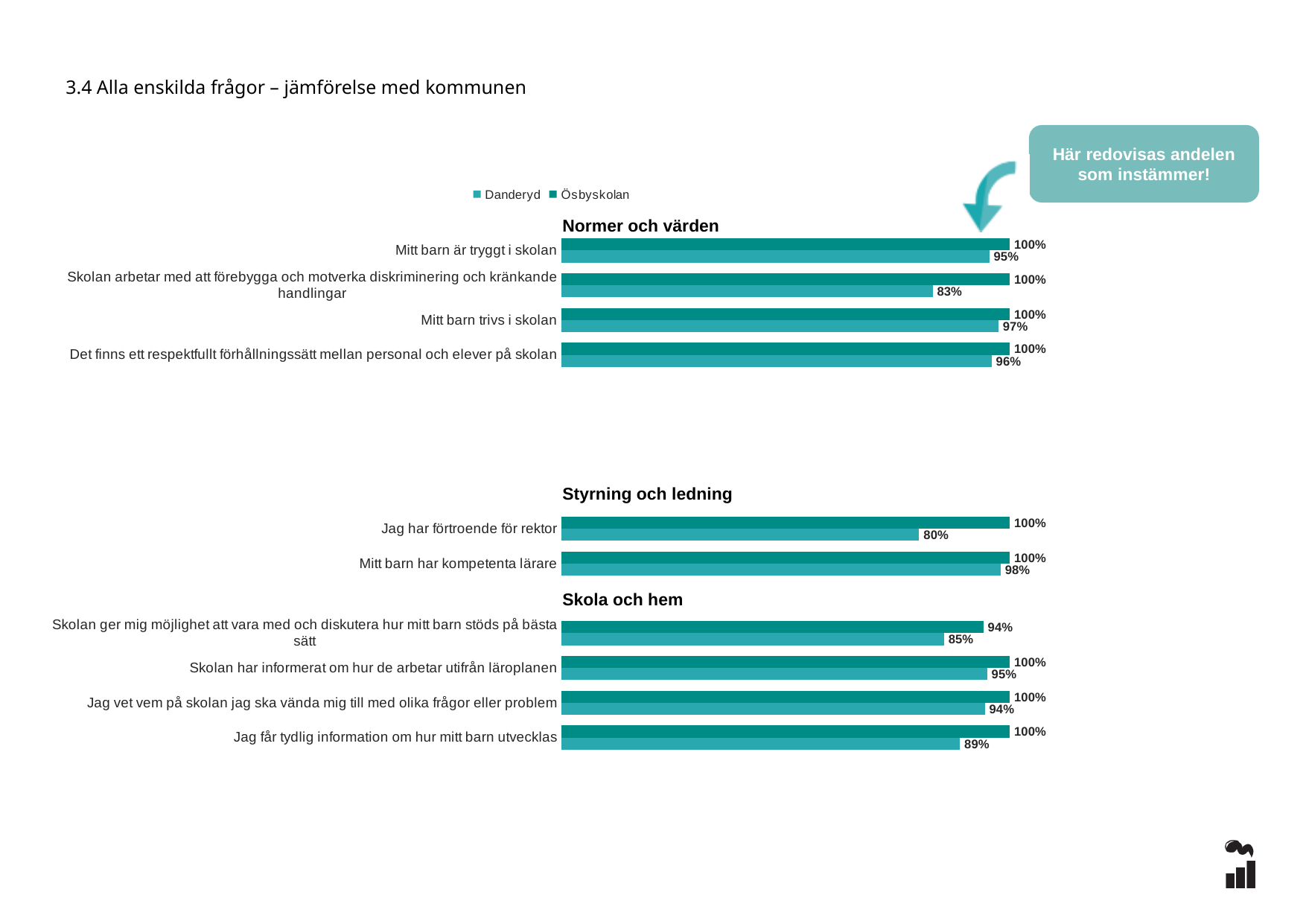
What is the Ösbyskolan value for "Skolan ger mig möjlighet att vara med och diskutera hur mitt barn stöds på bästa sätt"? 94% What are the two series named in the legend? Danderyd and Ösbyskolan What is the Danderyd value for "Mitt barn är tryggt i skolan"? 95% Which question has the lowest Danderyd value? Jag har förtroende för rektor What is the Danderyd value for "Jag har förtroende för rektor"? 80% How many series does the legend list? 2 What is the difference between the Ösbyskolan and Danderyd values for "Skolan arbetar med att förebygga och motverka diskriminering och kränkande handlingar"? 17 percentage points What kind of chart is shown on the slide? bar chart Which is larger for "Mitt barn trivs i skolan": the Danderyd value or the Ösbyskolan value? Ösbyskolan Which question has the highest Danderyd value? Mitt barn har kompetenta lärare How many questions are plotted under the heading "Skola och hem"? 4 What is the Danderyd value for "Jag får tydlig information om hur mitt barn utvecklas"? 89%